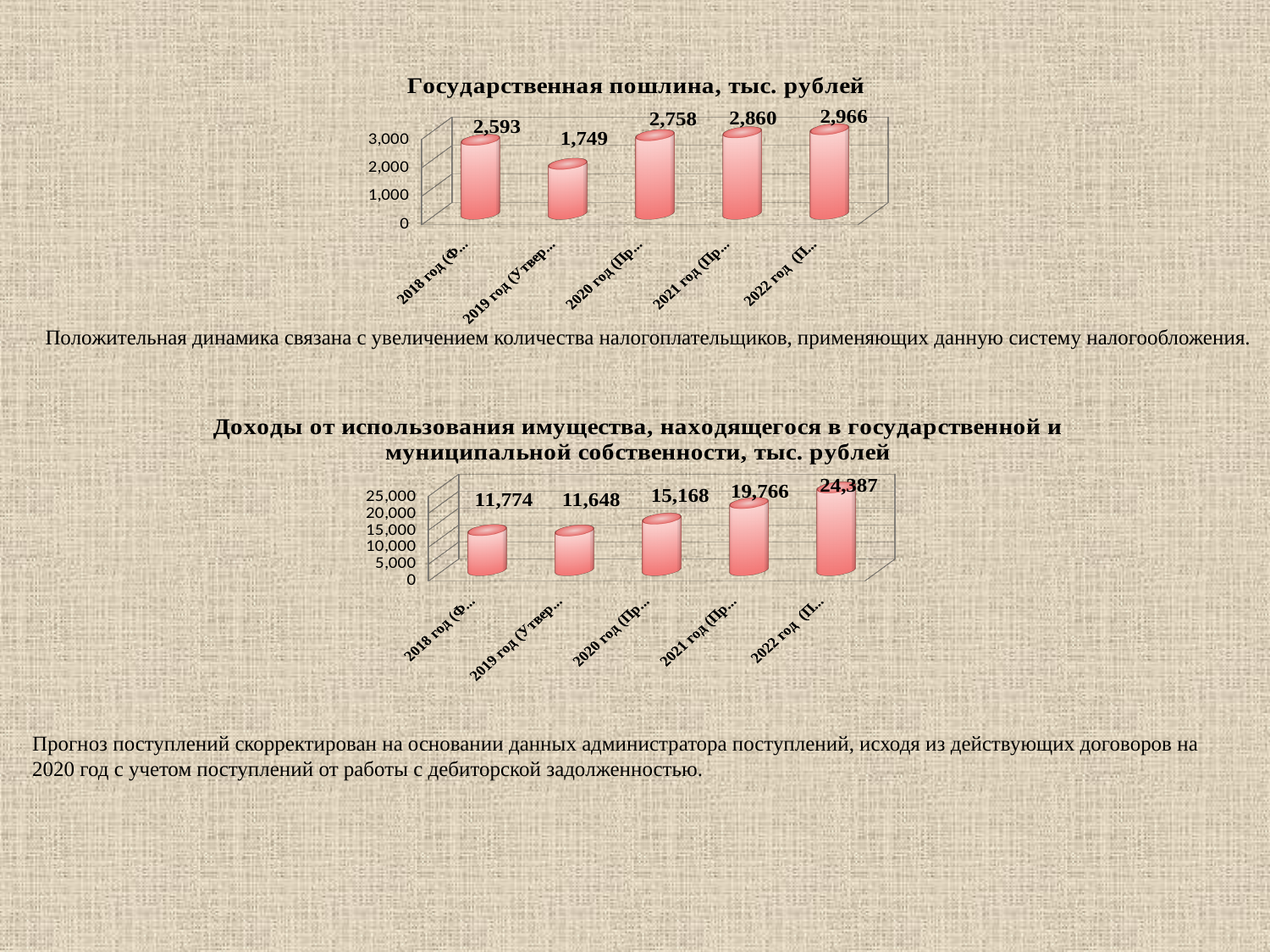
In the chart titled "Государственная пошлина, тыс. рублей", what is the difference between the values for 2022 год and 2018 год? 373 In the bottom chart (Доходы от использования имущества), is the value for 2020 год greater or less than 20,000? less In the bottom chart (Доходы от использования имущества), what is the difference between the values for 2022 год and 2021 год? 4,621 In the bottom chart (Доходы от использования имущества), which is larger, the value for 2018 год or 2019 год? 2018 год In the chart titled "Государственная пошлина, тыс. рублей", what is the value for 2019 год? 1,749 In the chart titled "Государственная пошлина, тыс. рублей", how many bars are plotted? 5 What kind of chart is the top chart on the slide? Bar chart In the bottom chart (Доходы от использования имущества), which year has the highest value? 2022 год In the bottom chart (Доходы от использования имущества), do the values rise or fall from 2019 год to 2022 год? Rise In the chart titled "Государственная пошлина, тыс. рублей", which year has the highest value? 2022 год In the bottom chart (Доходы от использования имущества), what is the value for 2021 год? 19,766 In the chart titled "Государственная пошлина, тыс. рублей", which year has the lowest value? 2019 год